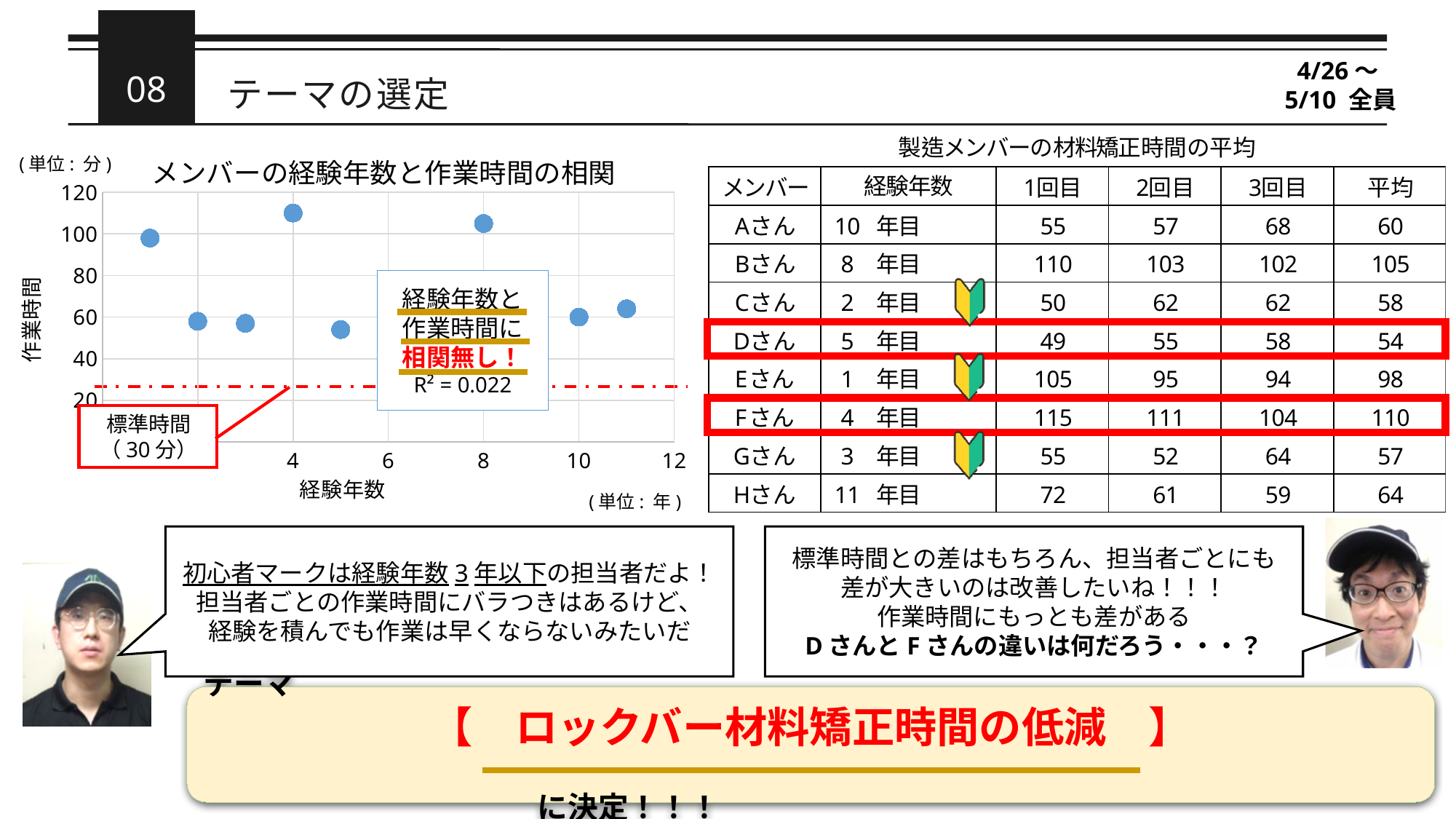
In the chart 「メンバーの経験年数と作業時間の相関」, which has the larger 作業時間: 経験年数 8 or 経験年数 10? 経験年数 8 In the chart 「メンバーの経験年数と作業時間の相関」, is the 作業時間 value for 経験年数 4 greater or less than 100? greater In the chart 「メンバーの経験年数と作業時間の相関」, is the 作業時間 value for 経験年数 5 greater or less than 60? less In the chart 「メンバーの経験年数と作業時間の相関」, is the 作業時間 value for 経験年数 11 greater or less than 80? less How many data points are plotted in the chart 「メンバーの経験年数と作業時間の相関」? 8 Does 作業時間 consistently fall as 経験年数 increases in the chart 「メンバーの経験年数と作業時間の相関」? No What kind of chart is 「メンバーの経験年数と作業時間の相関」? scatter chart What R² value is shown on the chart 「メンバーの経験年数と作業時間の相関」? R² = 0.022 In the chart 「メンバーの経験年数と作業時間の相関」, what is the 作業時間 value for 経験年数 10? 60 In the chart 「メンバーの経験年数と作業時間の相関」, which 経験年数 has the highest 作業時間? 4 What 標準時間 is marked by the dashed line on the chart 「メンバーの経験年数と作業時間の相関」? 30分